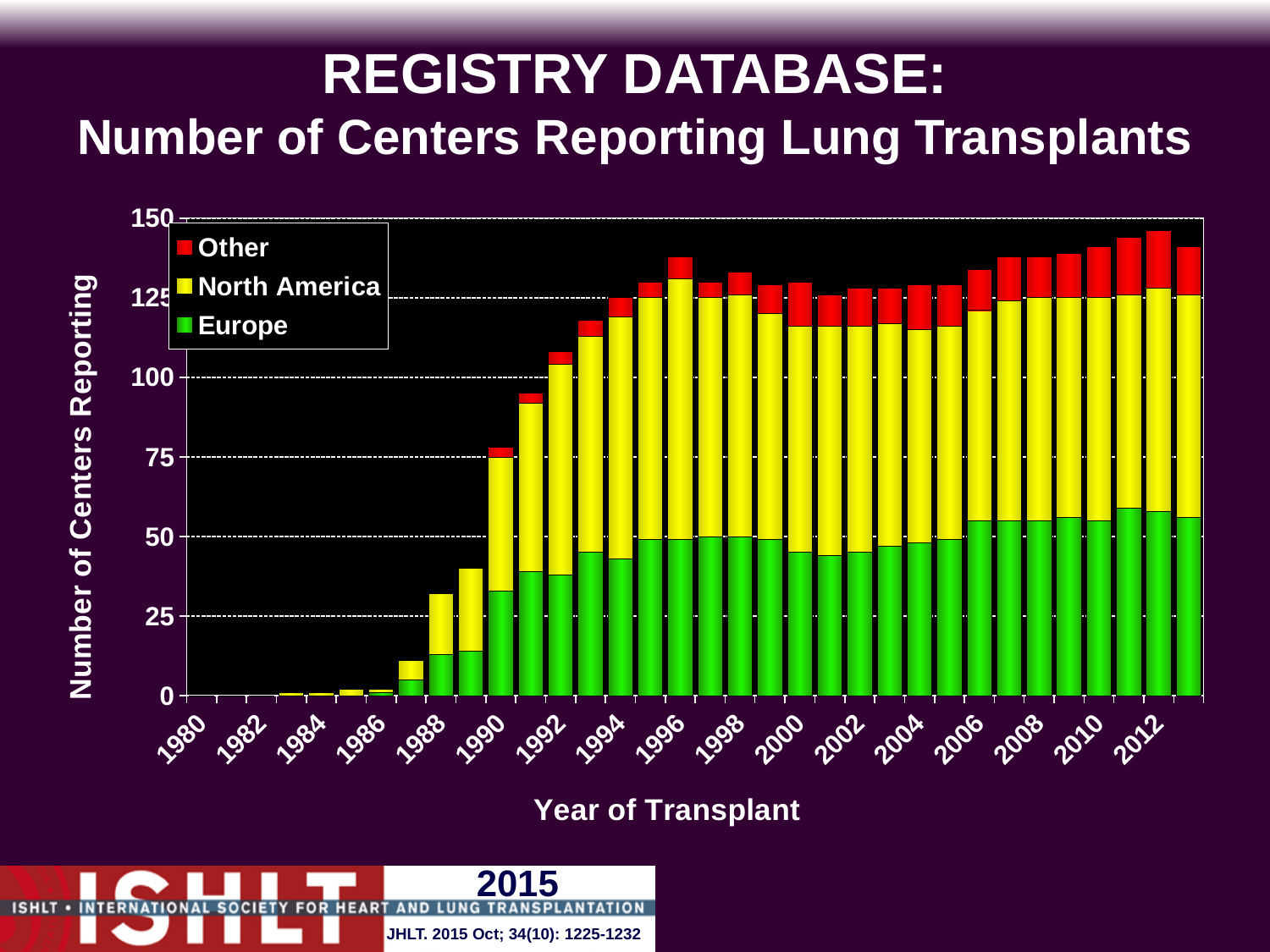
Is the number of European centers reporting in 2012 greater or less than 50? greater What is the title of the vertical axis? Number of Centers Reporting Is the total number of centers reporting in 1991 greater or less than 75? greater Is the total number of centers reporting in 1988 greater or less than 25? greater Which series is shown in green? Europe Does the total number of centers reporting rise or fall between 1986 and 1996? rise Which is larger, the total number of centers reporting in 1994 or in 1988? 1994 What kind of chart is shown on the slide? stacked bar chart How many series does the legend list? 3